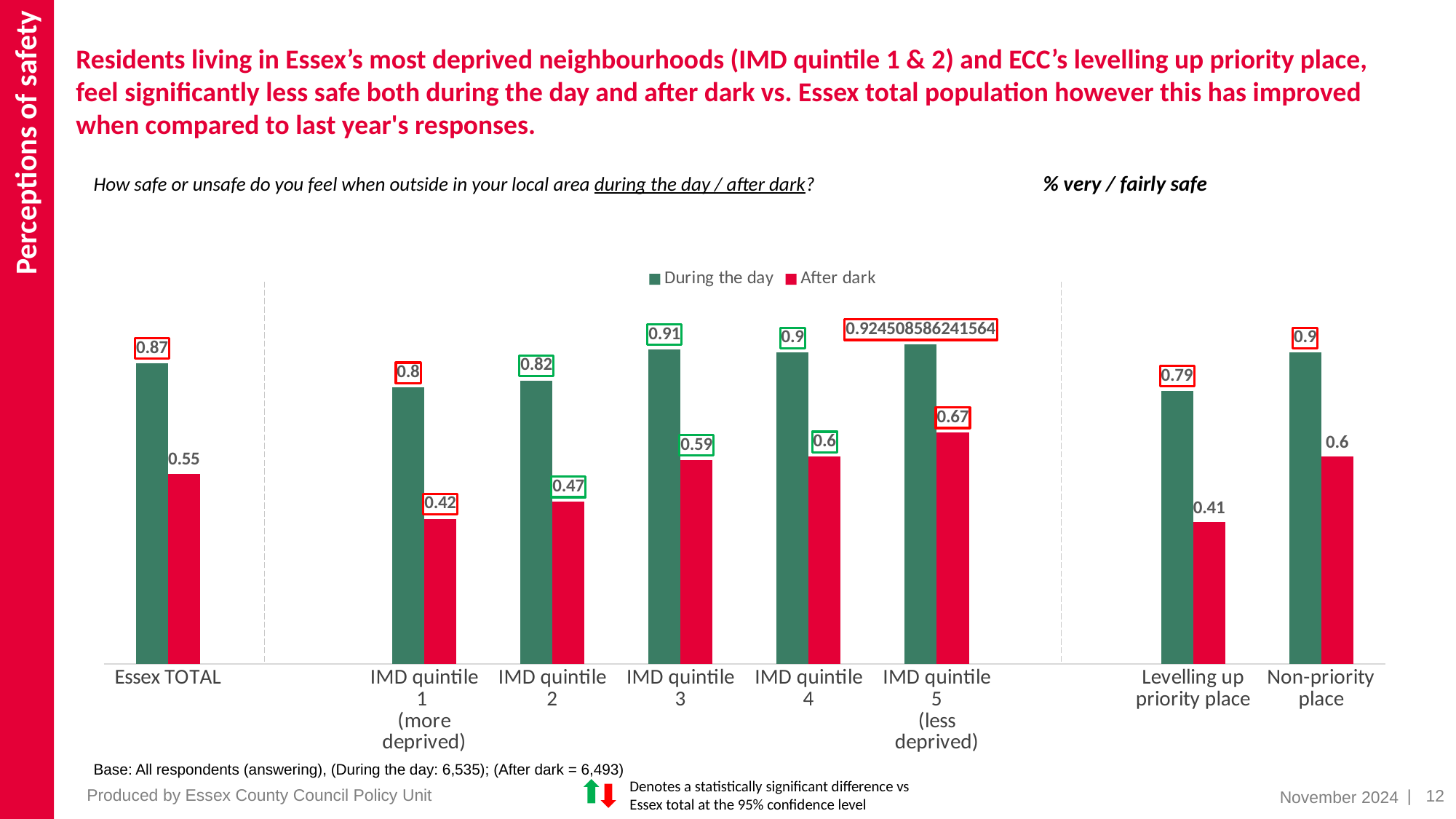
What kind of chart is shown on the slide? Bar chart How many categories are shown on the x axis of the chart? 8 Which is larger: the 'After dark' value for IMD quintile 2 or for IMD quintile 4? IMD quintile 4 What is the difference between the 'During the day' and 'After dark' values for Essex TOTAL? 0.32 What is the difference between the 'During the day' and 'After dark' values for IMD quintile 1 (more deprived)? 0.38 How many series does the chart legend list? 2 Which category has the lowest 'During the day' value? Levelling up priority place What is the 'During the day' value for Essex TOTAL? 0.87 What is the 'After dark' value for the Levelling up priority place? 0.41 Which category has the highest 'After dark' value? IMD quintile 5 (less deprived) What is the 'After dark' value for IMD quintile 1 (more deprived)? 0.42 What is the 'During the day' value for IMD quintile 3? 0.91